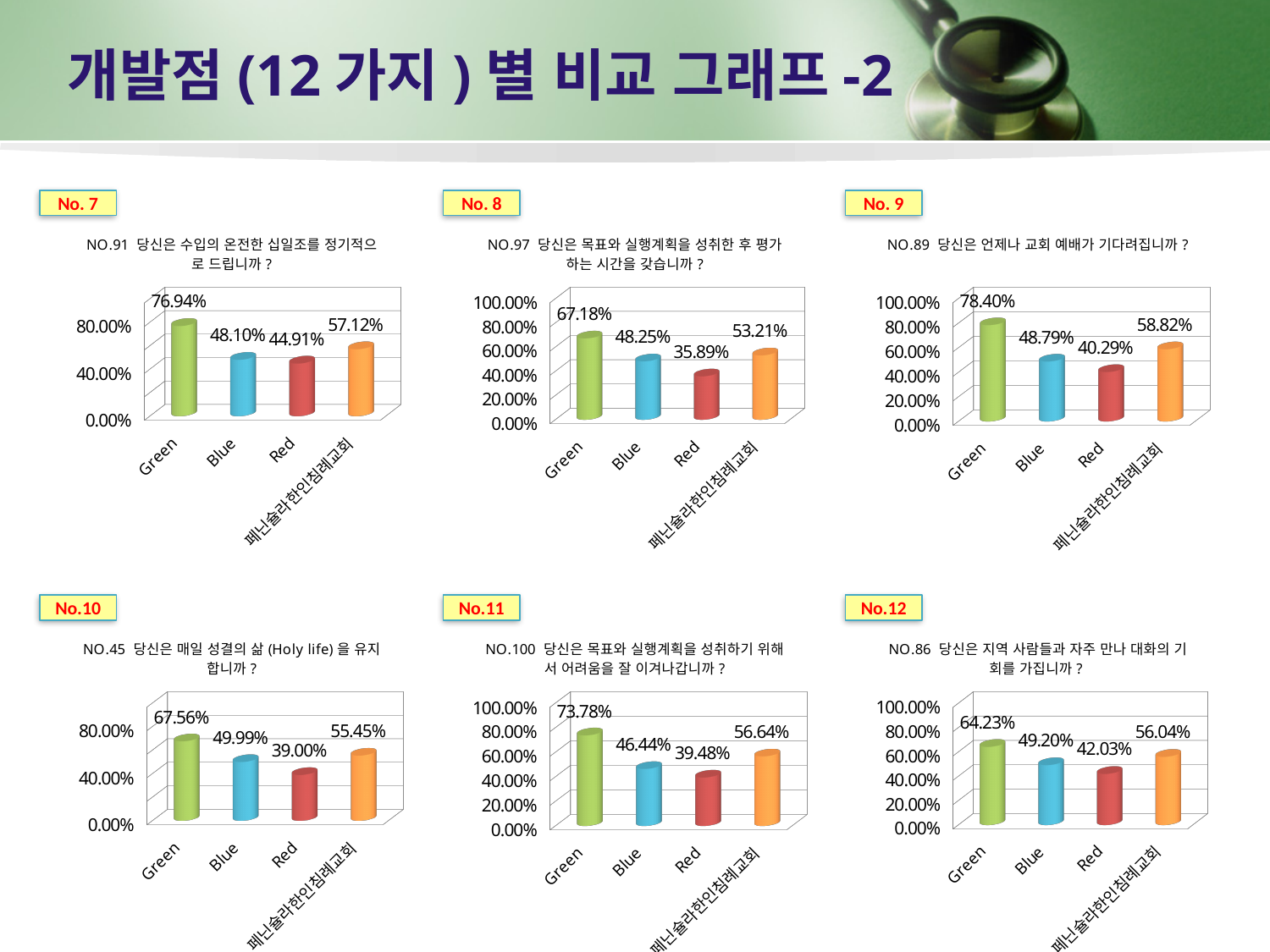
What kind of chart is the No. 8 chart (NO.97)? Bar chart In the No.12 chart (NO.86), what is the value for Blue? 49.20% How many categories are shown in the No.11 chart (NO.100)? 4 In the No. 8 chart (NO.97), what is the value for Red? 35.89% In the No.10 chart (NO.45), which category has the lowest value? Red In the No. 7 chart (NO.91), what is the difference between the Green and Blue values? 28.84% In the No. 9 chart (NO.89), what is the value for 페닌슐라한인침례교회? 58.82% In the No.12 chart (NO.86), what is the difference between the Blue and Red values? 7.17% How many charts are shown on the slide? 6 In the No. 9 chart (NO.89), which is larger, the value for Blue or the value for 페닌슐라한인침례교회? 페닌슐라한인침례교회 In the No. 7 chart (NO.91), what is the value for Green? 76.94% In the No.11 chart (NO.100), which category has the highest value? Green